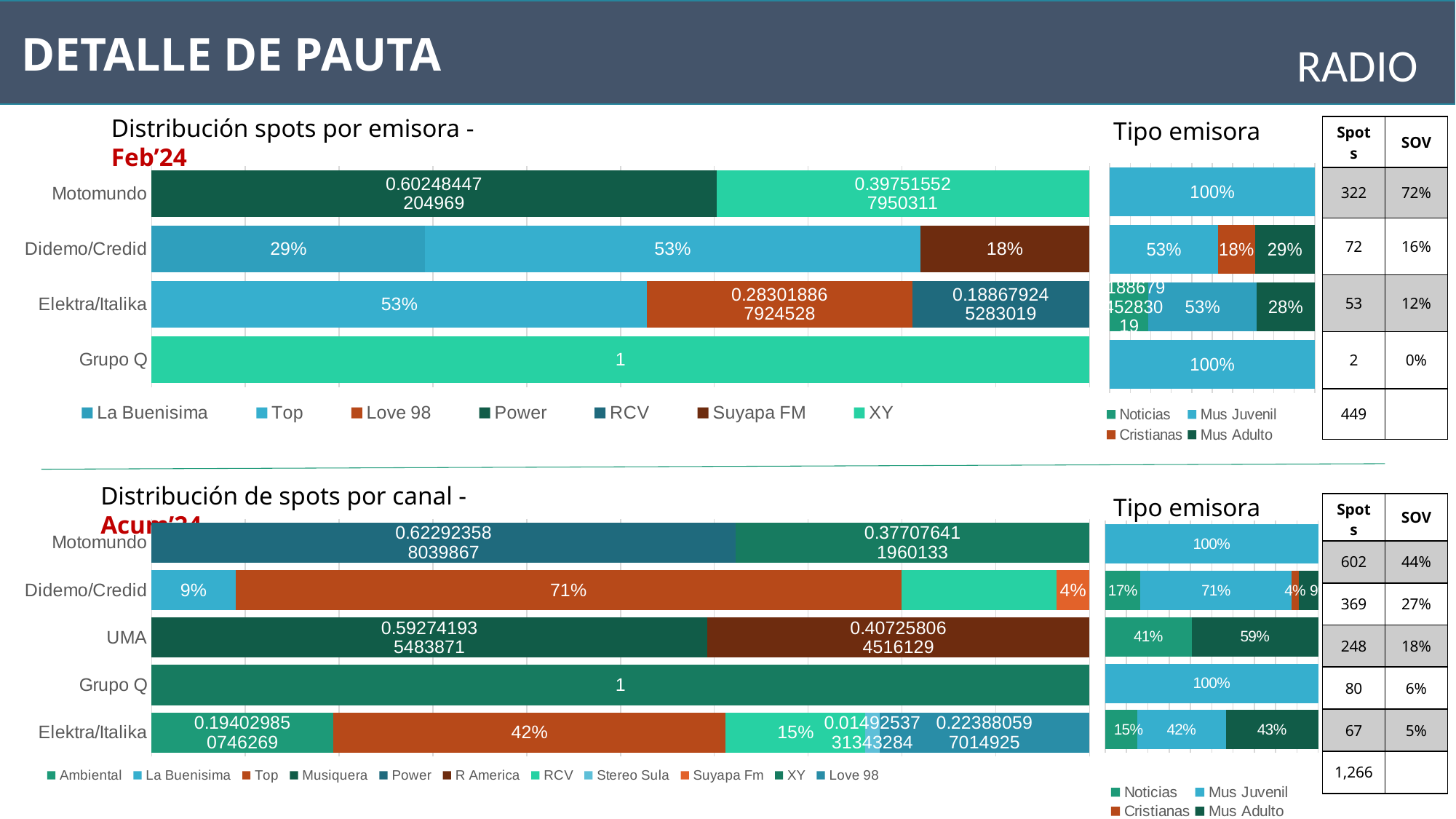
How many series does the legend of the 'Distribución de spots por canal - Acum'24' chart list? 11 In the 'Distribución spots por emisora - Feb'24' chart, what is the value of the Suyapa FM segment for Didemo/Credid? 18% In the 'Distribución spots por emisora - Feb'24' chart, what is the difference between the Top segment (53%) and the La Buenisima segment (29%) for Didemo/Credid? 24 percentage points In the 'Distribución spots por emisora - Feb'24' chart, what is the value of the Top segment for Didemo/Credid? 53% What kind of chart is the 'Distribución spots por emisora - Feb'24' chart? Stacked bar chart How many categories are shown in the 'Distribución de spots por canal - Acum'24' chart? 5 How many series does the legend of the 'Distribución spots por emisora - Feb'24' chart list? 7 In the 'Distribución de spots por canal - Acum'24' chart, what is the value of the Top segment for Didemo/Credid? 71% In the bottom 'Tipo emisora' chart (Acum'24), what is the Mus Adulto share for UMA? 59% In the 'Distribución spots por emisora - Feb'24' chart, which is larger for Didemo/Credid: the La Buenisima segment or the Suyapa FM segment? La Buenisima In the top 'Tipo emisora' chart (Feb'24), what is the Mus Adulto share for Didemo/Credid? 29% How many emisoras (categories) are shown in the 'Distribución spots por emisora - Feb'24' chart? 4